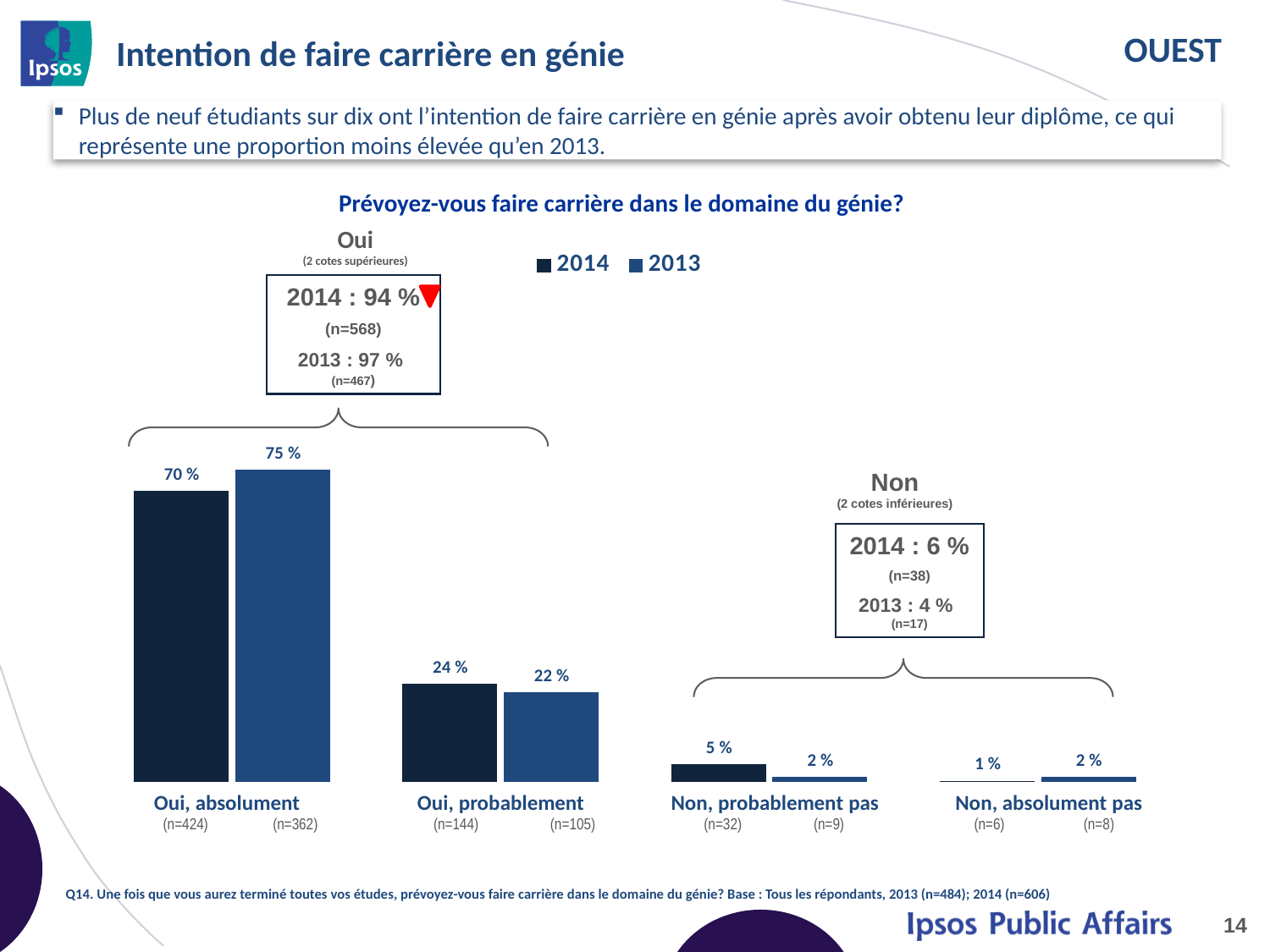
What is the title of the chart? Prévoyez-vous faire carrière dans le domaine du génie? What is the 2014 value for "Non, probablement pas"? 5 % Which category has the highest 2013 value? Oui, absolument Which category has the lowest 2014 value? Non, absolument pas For "Oui, probablement", which year has the larger value, 2014 or 2013? 2014 What kind of chart is shown on the slide? Bar chart What is the difference between the 2013 and 2014 values for "Oui, absolument"? 5 % How many series does the legend list? 2 What is the 2013 value for "Non, absolument pas"? 2 % How many categories are shown on the x axis of the chart? 4 What is the 2013 value for "Oui, probablement"? 22 % What is the 2014 value for "Oui, absolument"? 70 %